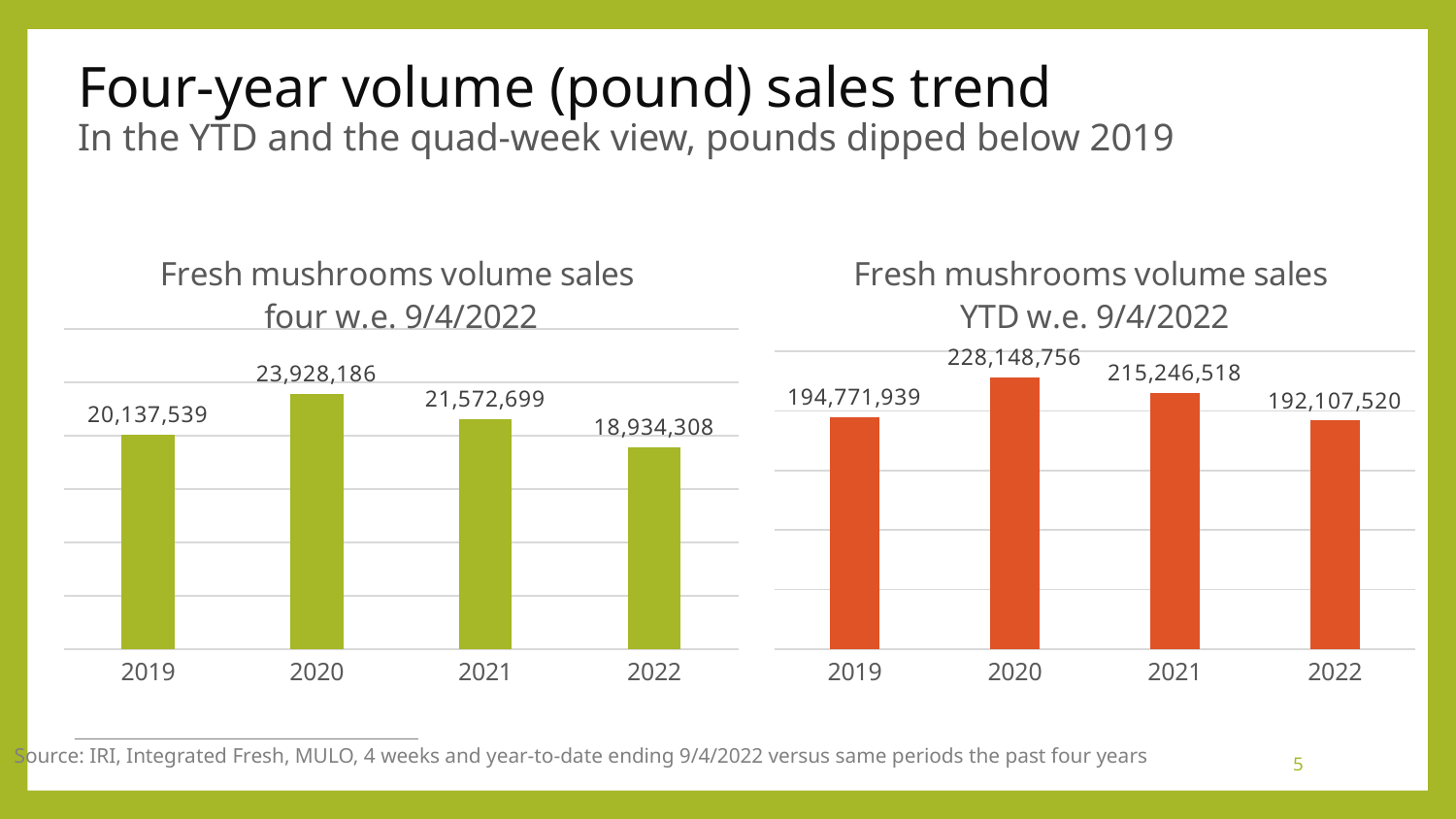
In the 'Fresh mushrooms volume sales YTD w.e. 9/4/2022' chart, what is the difference between the 2020 and 2022 values? 36,041,236 In the 'Fresh mushrooms volume sales YTD w.e. 9/4/2022' chart, do the values rise or fall from 2020 to 2022? Fall In the 'Fresh mushrooms volume sales four w.e. 9/4/2022' chart, what is the value for 2020? 23,928,186 In the 'Fresh mushrooms volume sales four w.e. 9/4/2022' chart, what is the difference between the 2020 and 2019 values? 3,790,647 What colour are the bars in the 'Fresh mushrooms volume sales four w.e. 9/4/2022' chart? Green In the 'Fresh mushrooms volume sales YTD w.e. 9/4/2022' chart, which is larger, the value for 2019 or the value for 2022? 2019 How many years are shown in the 'Fresh mushrooms volume sales four w.e. 9/4/2022' chart? 4 In the 'Fresh mushrooms volume sales YTD w.e. 9/4/2022' chart, what is the value for 2022? 192,107,520 In the 'Fresh mushrooms volume sales four w.e. 9/4/2022' chart, which year has the lowest value? 2022 In the 'Fresh mushrooms volume sales four w.e. 9/4/2022' chart, which is larger, the value for 2021 or the value for 2019? 2021 In the 'Fresh mushrooms volume sales YTD w.e. 9/4/2022' chart, which year has the highest value? 2020 What kind of chart is the 'Fresh mushrooms volume sales YTD w.e. 9/4/2022' chart? Bar chart